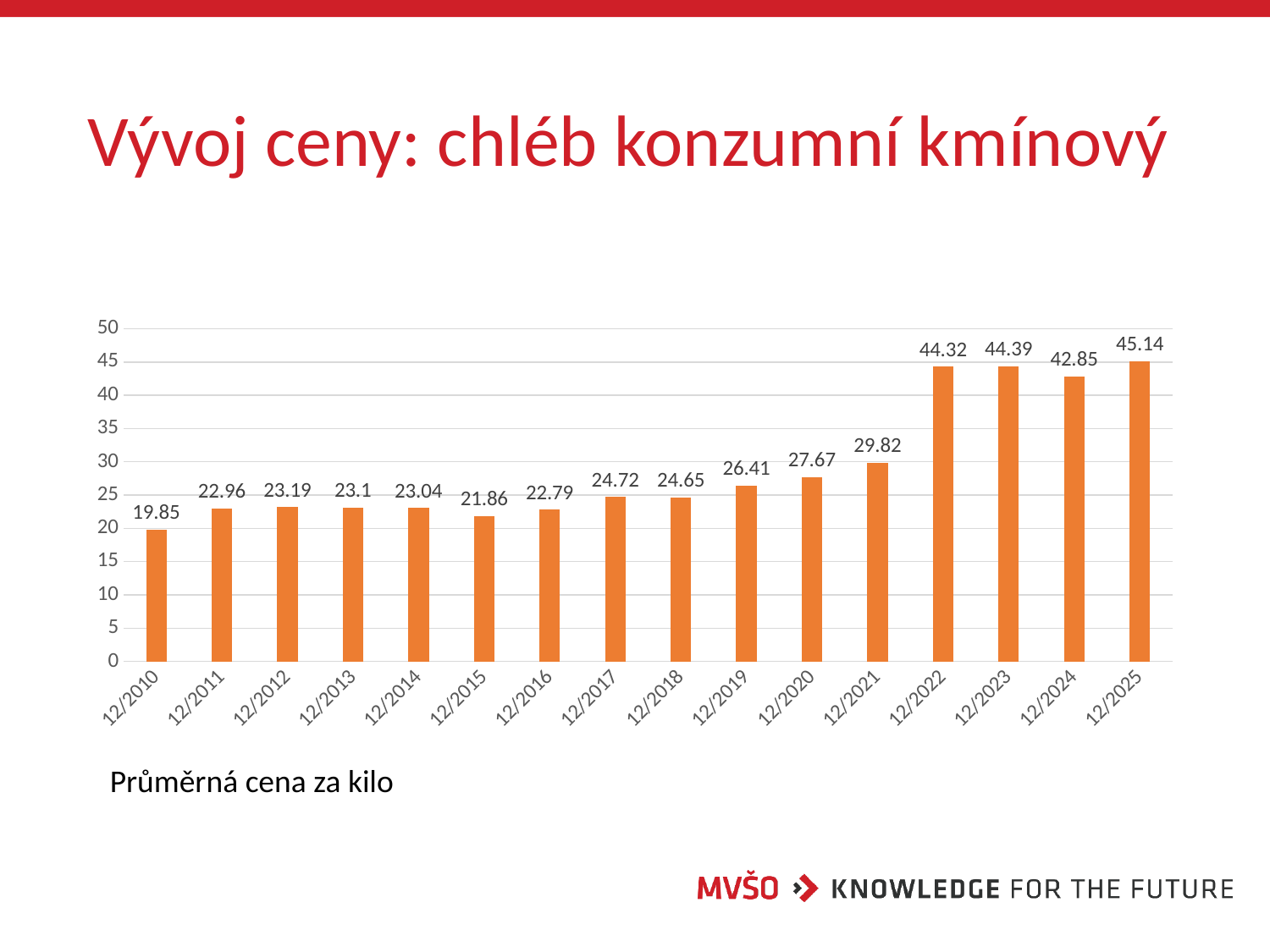
How many categories are shown on the x axis? 16 Which category has the lowest value? 12/2010 What is the value for 12/2015? 21.86 What is the difference between the values for 12/2022 and 12/2021? 14.5 Which is larger, the value for 12/2023 or the value for 12/2024? 12/2023 What is the value for 12/2021? 29.82 Is the value for 12/2020 greater or less than 25? greater What is the difference between the values for 12/2025 and 12/2010? 25.29 Which category has the highest value? 12/2025 What kind of chart is shown on the slide? bar chart What is the title of the slide? Vývoj ceny: chléb konzumní kmínový What is the value for 12/2010? 19.85